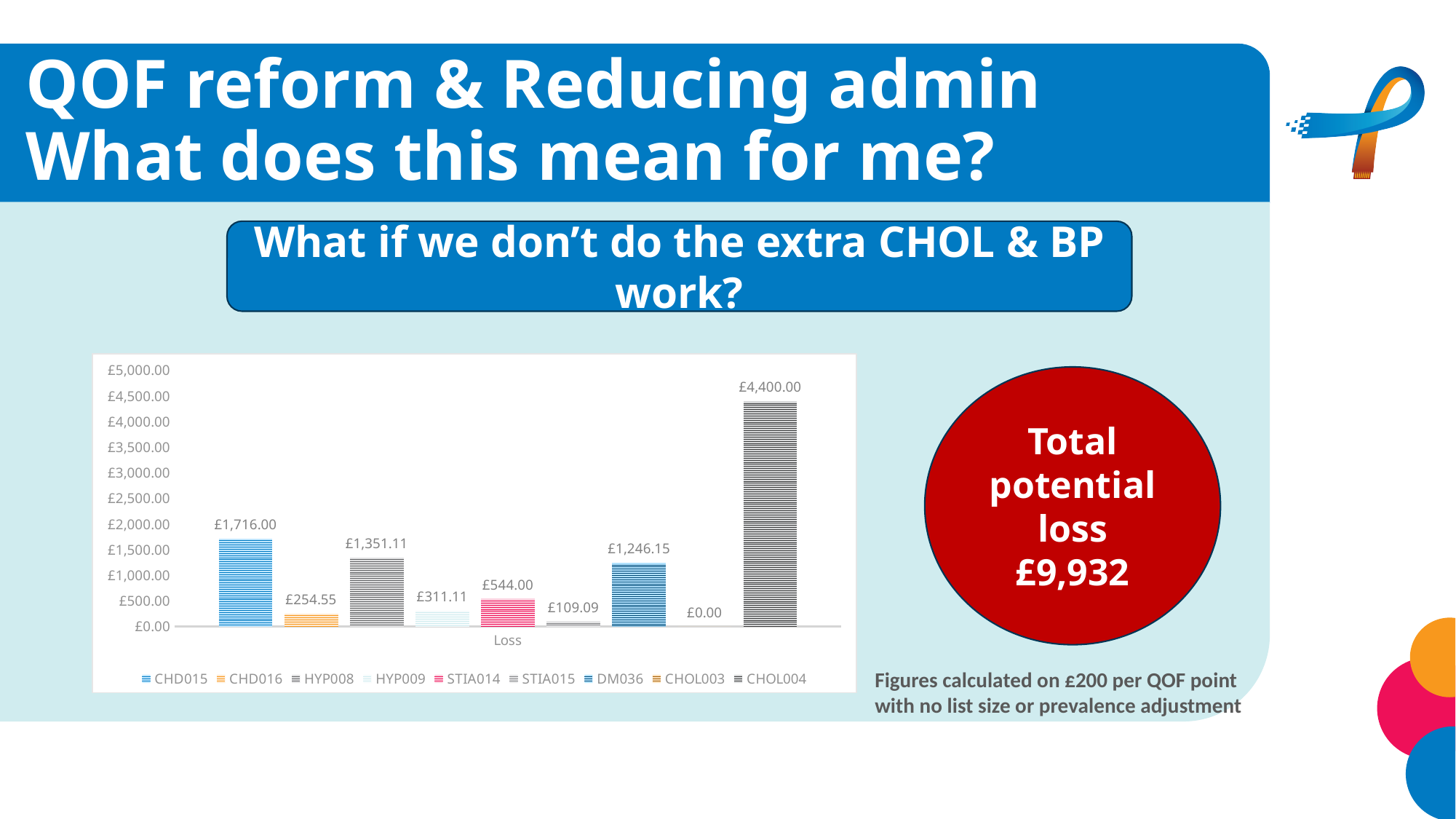
What is the loss value shown for STIA015? £109.09 How many series does the legend list? 9 What is the difference between the loss values for CHOL004 and CHD015? £2,684.00 Which series has the highest loss value in the chart? CHOL004 What is the loss value shown for CHD015? £1,716.00 What is the loss value shown for CHOL004? £4,400.00 What kind of chart is shown on the slide? Bar chart Is the value for STIA014 greater or less than £1,000.00? less What is the label on the x axis of the chart? Loss Which series has the lowest loss value in the chart? CHOL003 What is the loss value shown for DM036? £1,246.15 Which has a larger loss value, HYP008 or DM036? HYP008